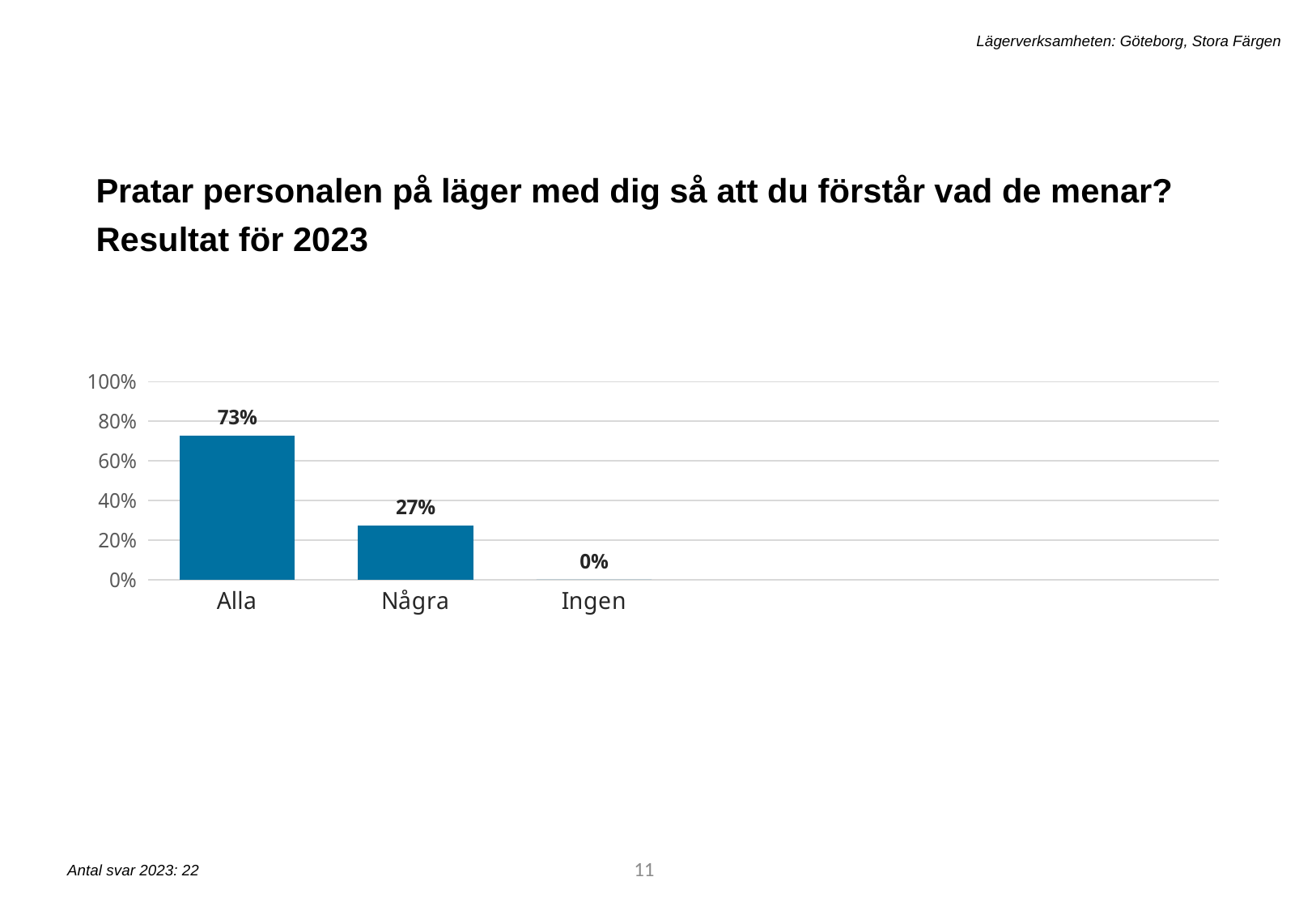
What is the difference between the values for Alla and Några? 46% Which is larger, the value for Några or the value for Ingen? Några Which category has the lowest value? Ingen What kind of chart is shown on the slide? bar chart Do the values rise or fall from left to right along the x axis? fall Which category has the highest value? Alla How many categories are shown on the x axis? 3 What is the value for Några? 27% Is the value for Alla greater or less than 60%? greater What is the value for Alla? 73% Is the value for Några greater or less than 40%? less What is the value for Ingen? 0%